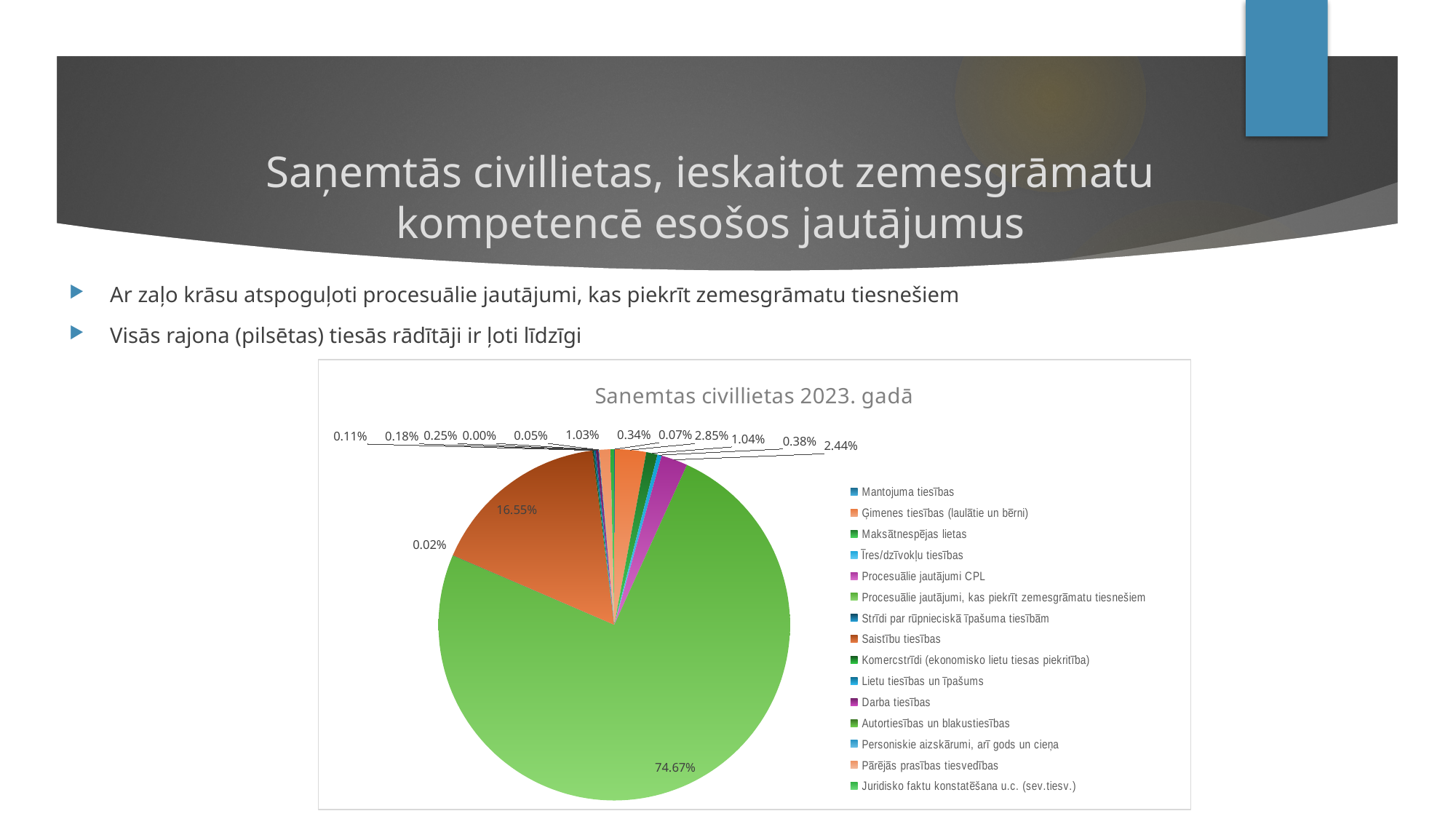
What is the second-largest percentage shown on the pie chart? 16.55% What type of chart is shown on the slide? pie chart What is the share of the pie for Saistību tiesības? 16.55% What is the title of the chart? Sanemtas civillietas 2023. gadā What is the largest percentage shown on the pie chart? 74.67% How many slices (data labels) does the pie chart have? 15 Which legend category corresponds to the largest slice of the pie? Procesuālie jautājumi, kas piekrīt zemesgrāmatu tiesnešiem Which is larger: the slice labelled 16.55% or the slice labelled 2.85%? 16.55% What is the smallest percentage label shown on the pie chart? 0.00% Is the largest slice of the pie greater or less than 50%? greater What is the difference between the largest slice (74.67%) and the second-largest slice (16.55%)? 58.12% How many entries does the chart legend list? 15